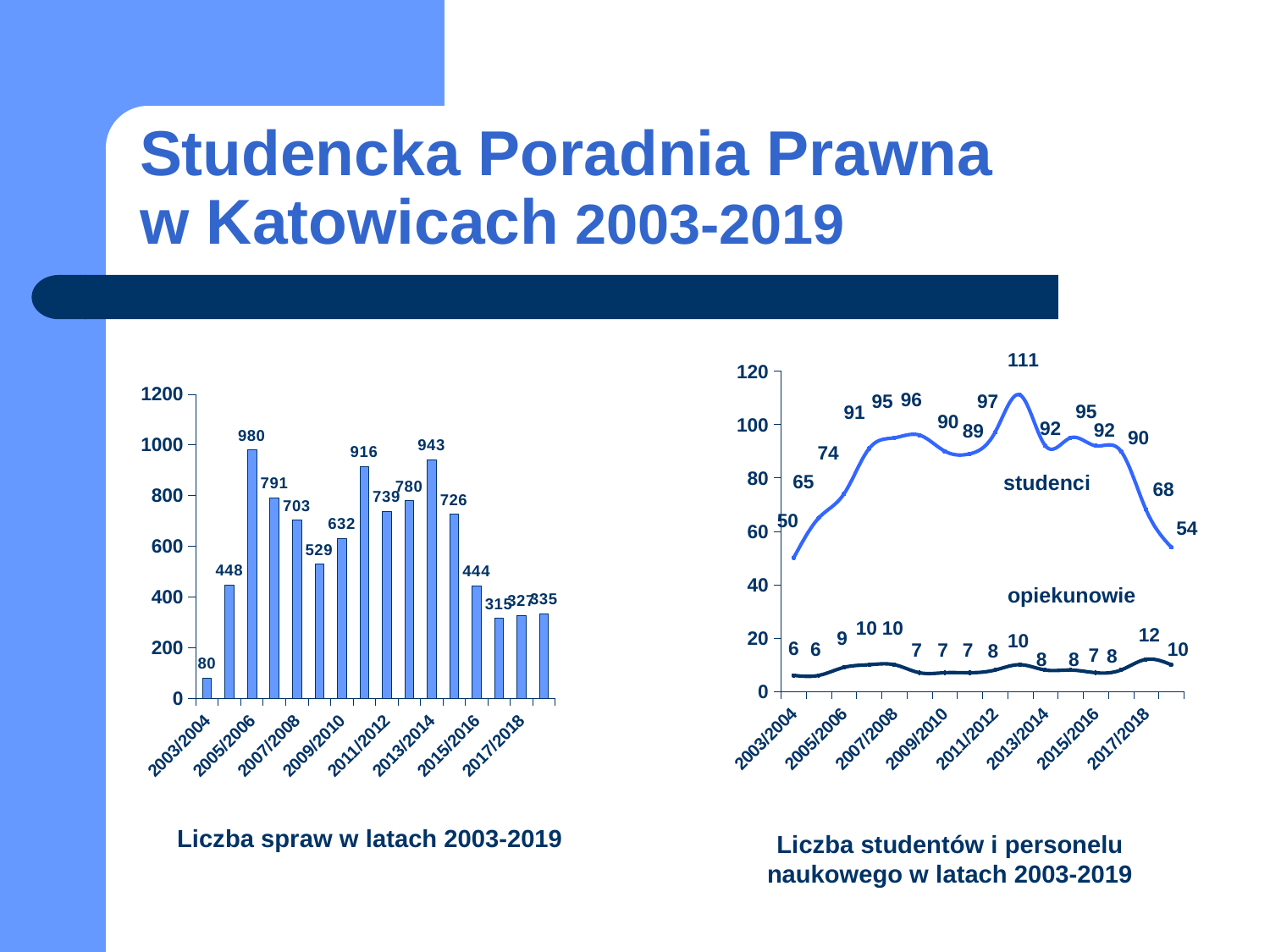
In the left chart 'Liczba spraw w latach 2003-2019', what is the value for 2003/2004? 80 In the right chart, is the 'studenci' value higher in 2005/2006 or in 2007/2008? 2007/2008 In the left chart 'Liczba spraw w latach 2003-2019', what is the difference between the values for 2013/2014 and 2015/2016? 499 In the left chart 'Liczba spraw w latach 2003-2019', which year has the lowest value? 2003/2004 In the left chart 'Liczba spraw w latach 2003-2019', what is the highest value shown? 980 In the right chart, what is the highest value of the 'studenci' series? 111 How many series are plotted in the right chart 'Liczba studentów i personelu naukowego w latach 2003-2019'? 2 In the right chart, what is the 'studenci' value for 2003/2004? 50 In the right chart, what is the highest value of the 'opiekunowie' series? 12 What kind of chart is the left chart, 'Liczba spraw w latach 2003-2019'? bar chart How many bars are plotted in the left chart 'Liczba spraw w latach 2003-2019'? 16 What kind of chart is the right chart, 'Liczba studentów i personelu naukowego w latach 2003-2019'? line chart